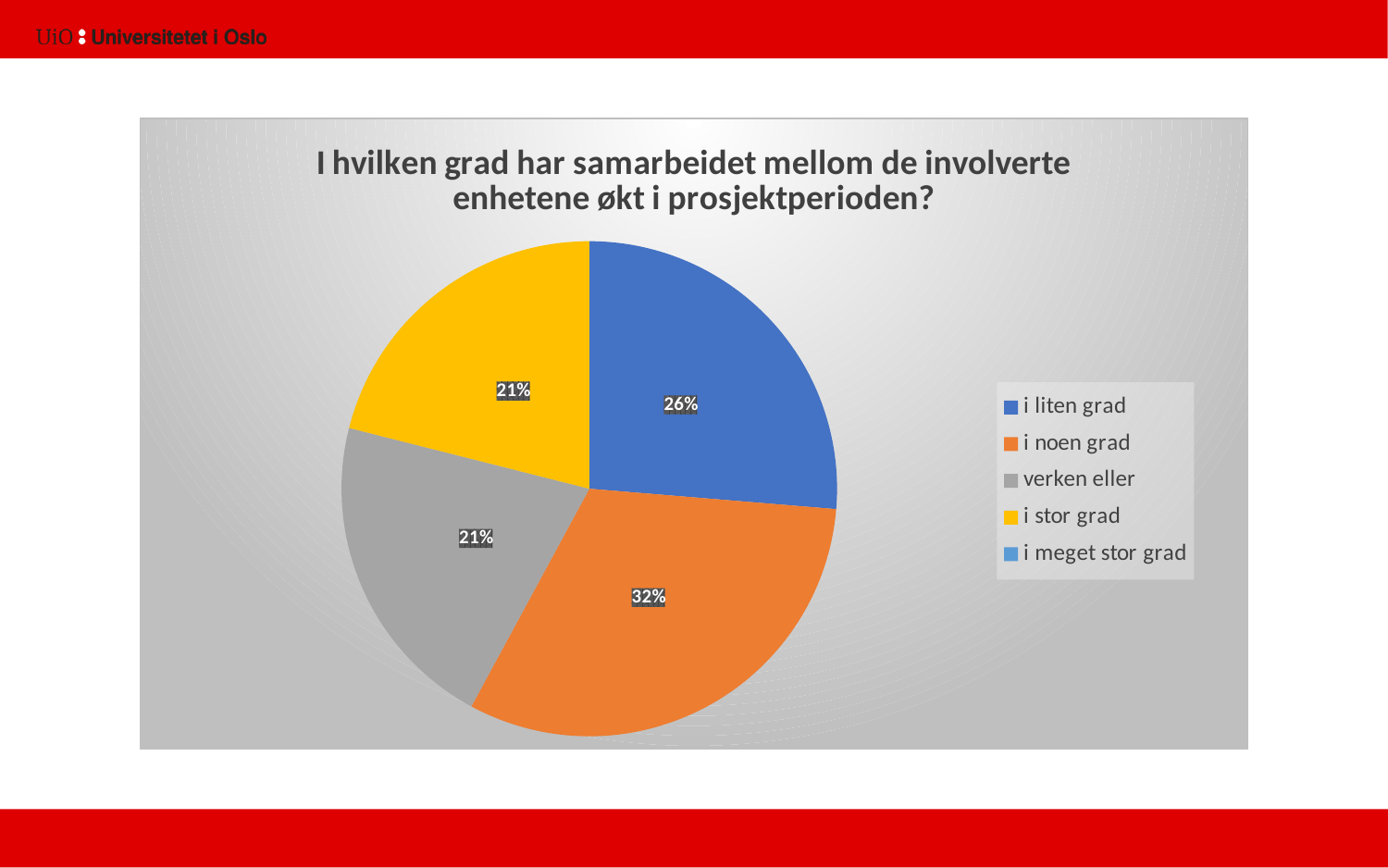
What share of the pie does "verken eller" have? 21% What is the difference in percentage points between "i liten grad" and "verken eller"? 5 What share of the pie does "i stor grad" have? 21% What colour is the slice for "i stor grad"? yellow Which is larger, the slice for "i liten grad" or the slice for "i stor grad"? i liten grad What share of the pie does "i liten grad" have? 26% How many entries does the legend list? 5 What share of the pie does "i noen grad" have? 32% What type of chart is shown on the slide? pie chart What is the title of the chart? I hvilken grad har samarbeidet mellom de involverte enhetene økt i prosjektperioden? What is the difference in percentage points between "i noen grad" and "i liten grad"? 6 Which category has the largest slice of the pie? i noen grad